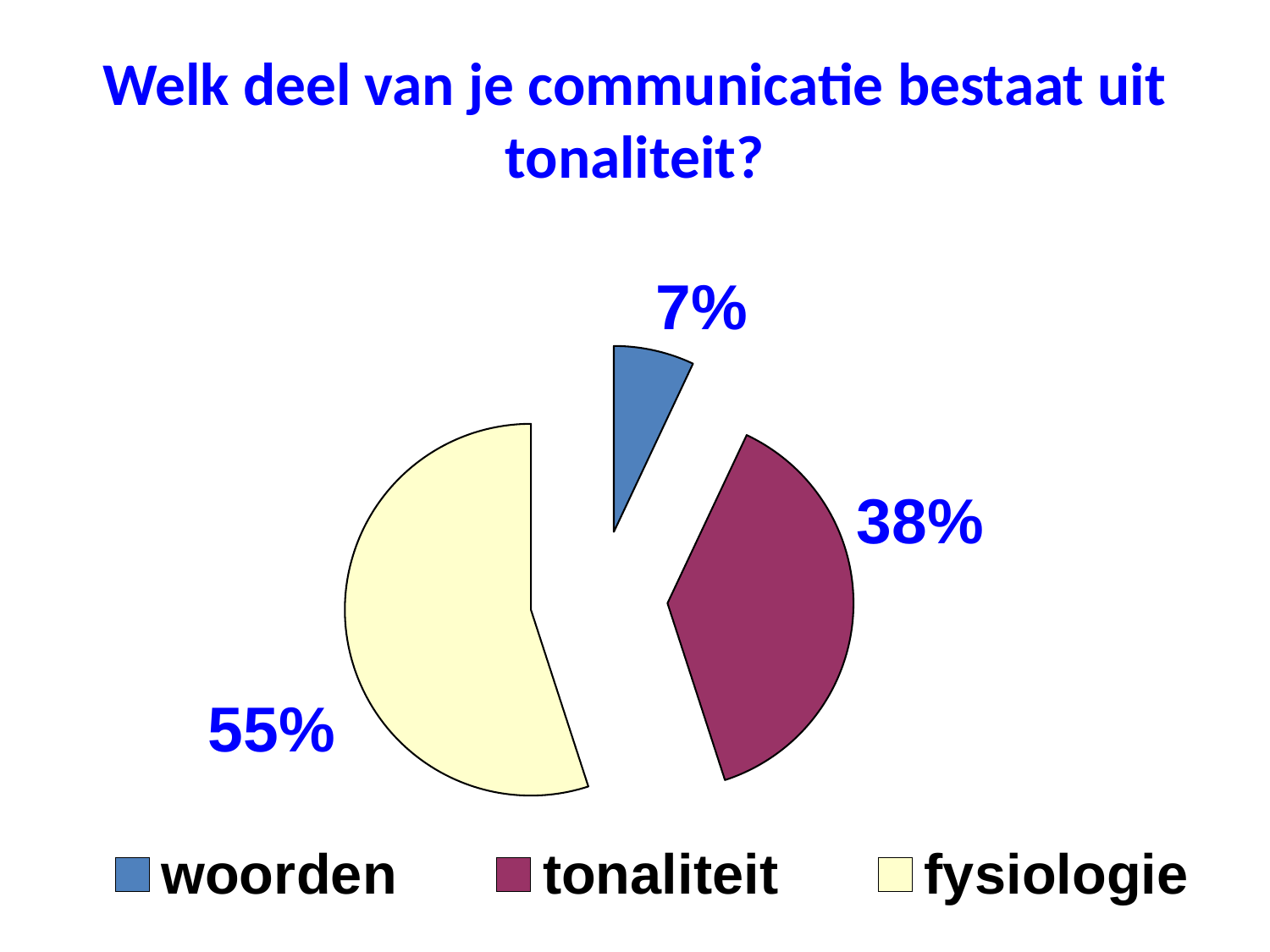
What share of the pie does fysiologie represent? 55% Which category has the largest slice of the pie? fysiologie What kind of chart is shown on the slide? pie chart Which category is shown in blue in the legend? woorden What is the difference in percentage points between fysiologie and tonaliteit? 17% What share of the pie does woorden represent? 7% Which category has the smallest slice of the pie? woorden What is the difference in percentage points between tonaliteit and woorden? 31% How many slices does the pie chart have? 3 What is the title of the slide? Welk deel van je communicatie bestaat uit tonaliteit? Which is larger, the slice for tonaliteit or the slice for woorden? tonaliteit What share of the pie does tonaliteit represent? 38%